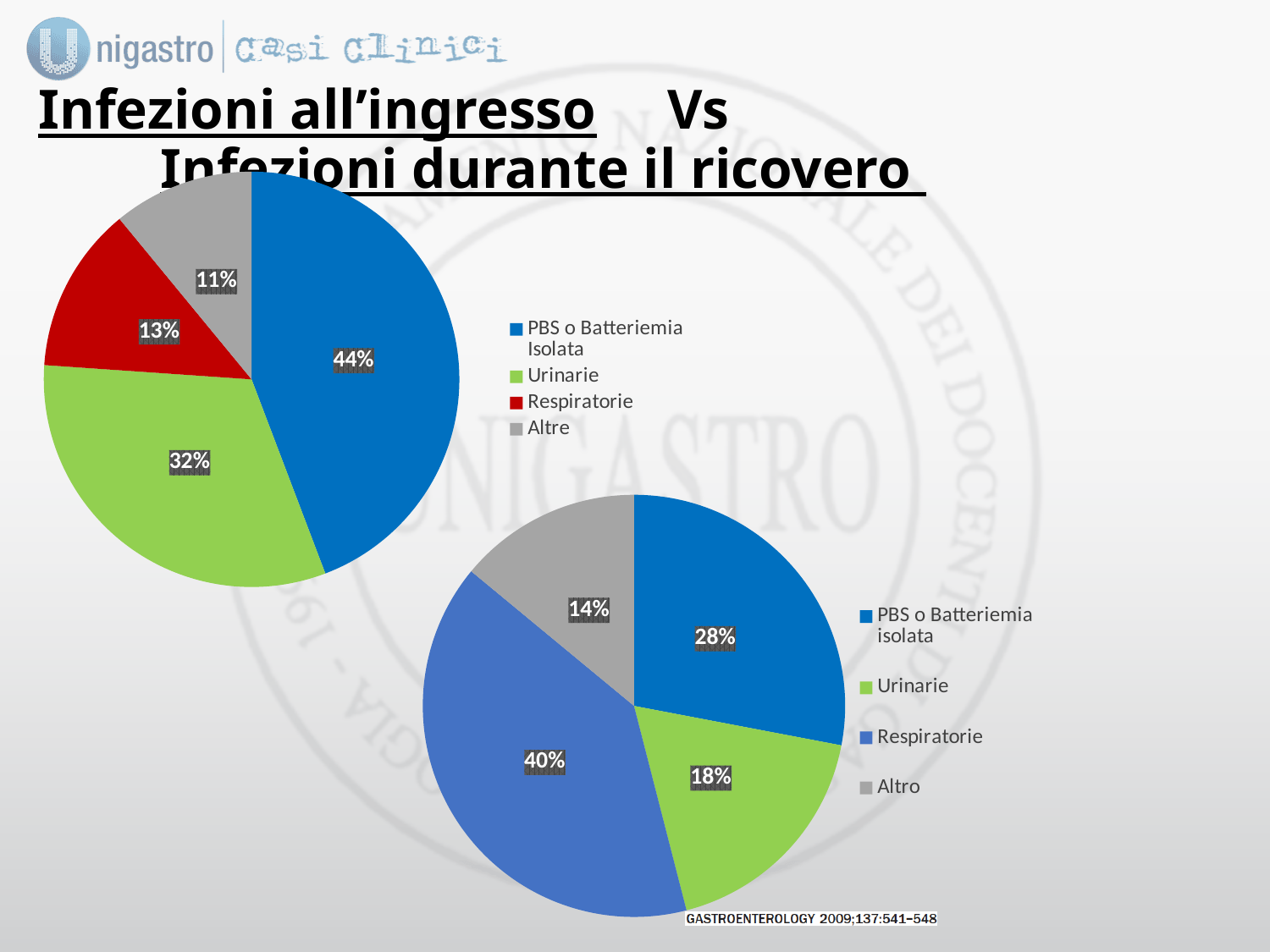
In the lower-right pie chart, what share is labelled for Altro? 14% In the lower-right pie chart, which is larger, PBS o Batteriemia isolata or Urinarie? PBS o Batteriemia isolata In the upper-left pie chart, which category has the smallest slice? Altre In the lower-right pie chart, what share is labelled for Respiratorie? 40% In the upper-left pie chart, what share is labelled for Respiratorie? 13% How many entries does the legend of the upper-left chart list? 4 In the upper-left pie chart, what share is labelled for Urinarie? 32% In the upper-left pie chart, which category has the largest slice? PBS o Batteriemia Isolata In the upper-left pie chart, what is the difference between the PBS o Batteriemia Isolata share and the Urinarie share? 12% How many slices does the lower-right pie chart have? 4 What type of chart is the upper-left chart? Pie chart In the lower-right pie chart, which category has the largest slice? Respiratorie